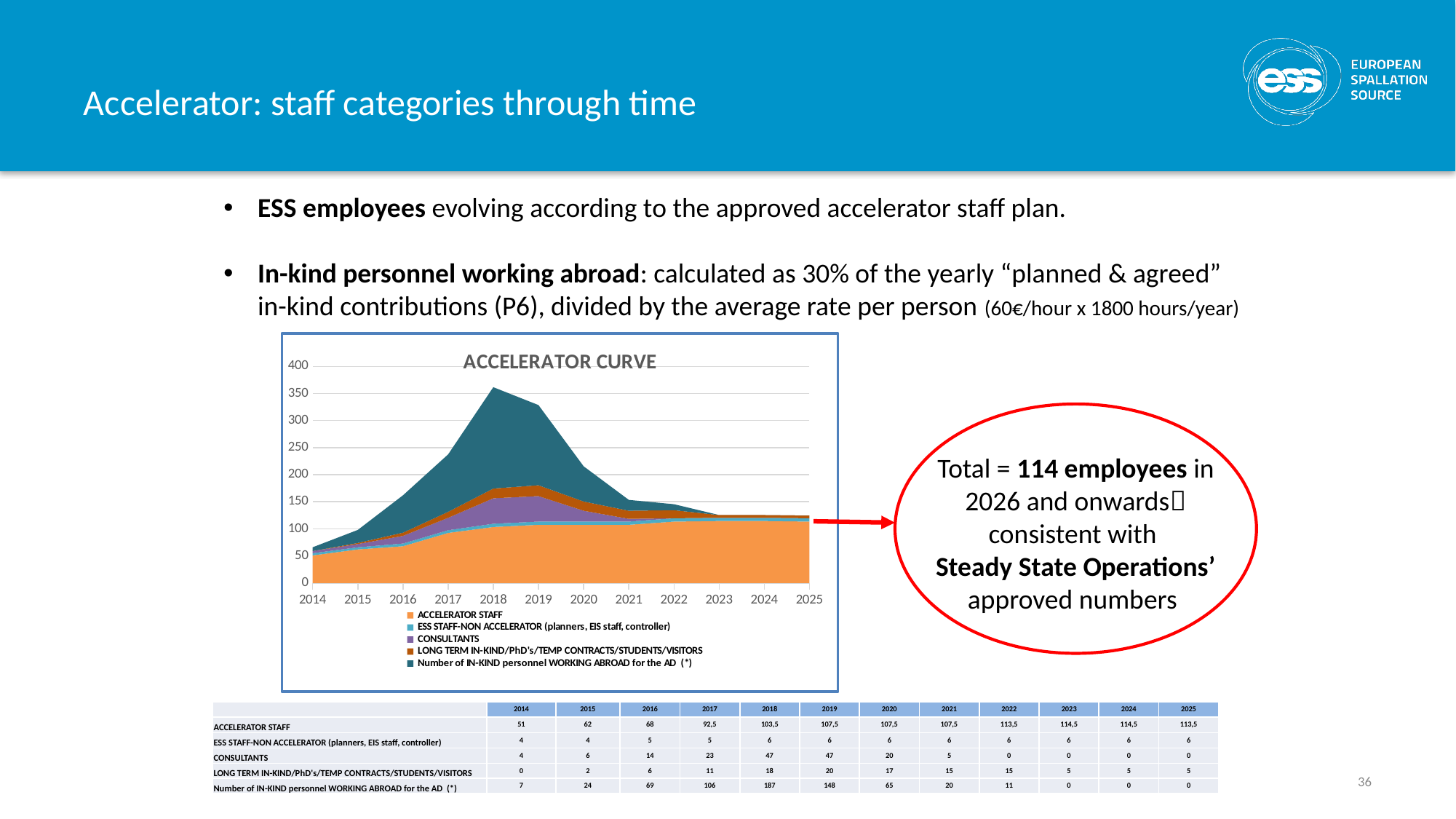
Which is larger, CONSULTANTS in 2016 or in 2017? 2017 What is the value for ACCELERATOR STAFF in 2018? 103,5 Is the total stacked value in 2018 greater or less than 300? greater What is the value for CONSULTANTS in 2017? 23 What is the Number of IN-KIND personnel WORKING ABROAD for the AD in 2018? 187 In which year is ACCELERATOR STAFF lowest? 2014 What kind of chart is the ACCELERATOR CURVE chart? Stacked area chart What is the total of all series in 2014? 66 In which year is the Number of IN-KIND personnel WORKING ABROAD for the AD highest? 2018 What is the difference between the Number of IN-KIND personnel WORKING ABROAD for the AD in 2018 and in 2019? 39 How many series does the legend of the ACCELERATOR CURVE chart list? 5 How many years are shown on the x axis of the ACCELERATOR CURVE chart? 12